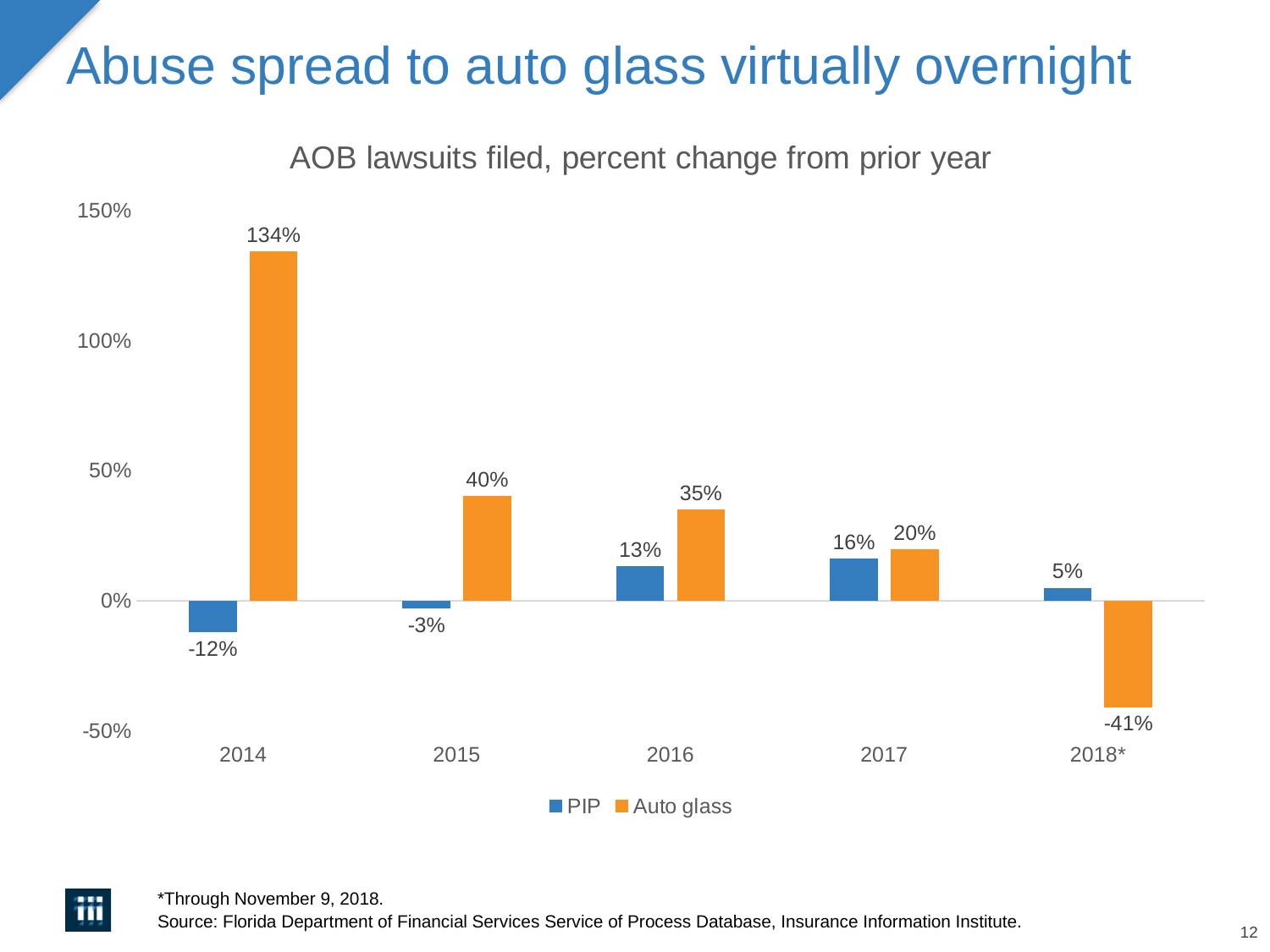
How many years are shown on the x axis? 5 In 2017, which series has the larger value, PIP or Auto glass? Auto glass What is the title of the chart? AOB lawsuits filed, percent change from prior year Which year has the highest Auto glass value? 2014 What kind of chart is shown? Bar chart What is the Auto glass value for 2018*? -41% What is the PIP value for 2017? 16% Which year has the lowest PIP value? 2014 What is the difference between the Auto glass and PIP values in 2016? 22% Is the Auto glass value for 2014 greater or less than 100%? greater What is the Auto glass value for 2014? 134% How many series does the legend list? 2